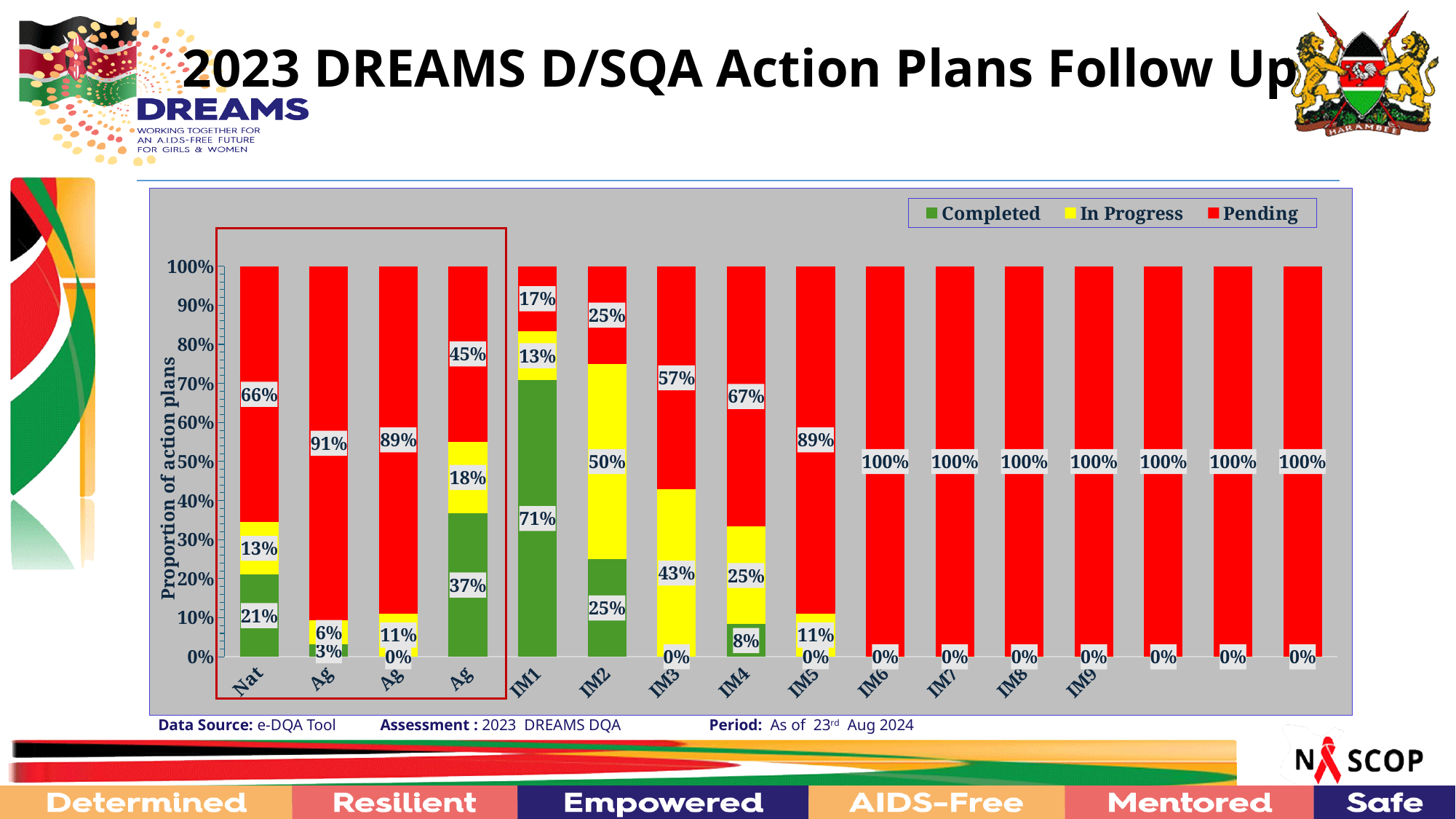
Among the IM categories (IM1 to IM9), which has the highest Completed value? IM1 What is the difference between the Pending value for IM5 and the Pending value for IM1? 72 percentage points Which colour represents the Pending series in the legend? Red What is the Pending value for Nat? 66% What is the In Progress value for IM2? 50% Which has the larger Pending value, IM4 or IM2? IM4 How many series does the legend list? 3 What is the title of the vertical axis? Proportion of action plans How many bars show a Pending value of 100%? 7 What is the Completed value for IM1? 71% What kind of chart is shown on the slide? Stacked bar chart What is the Completed value for IM4? 8%